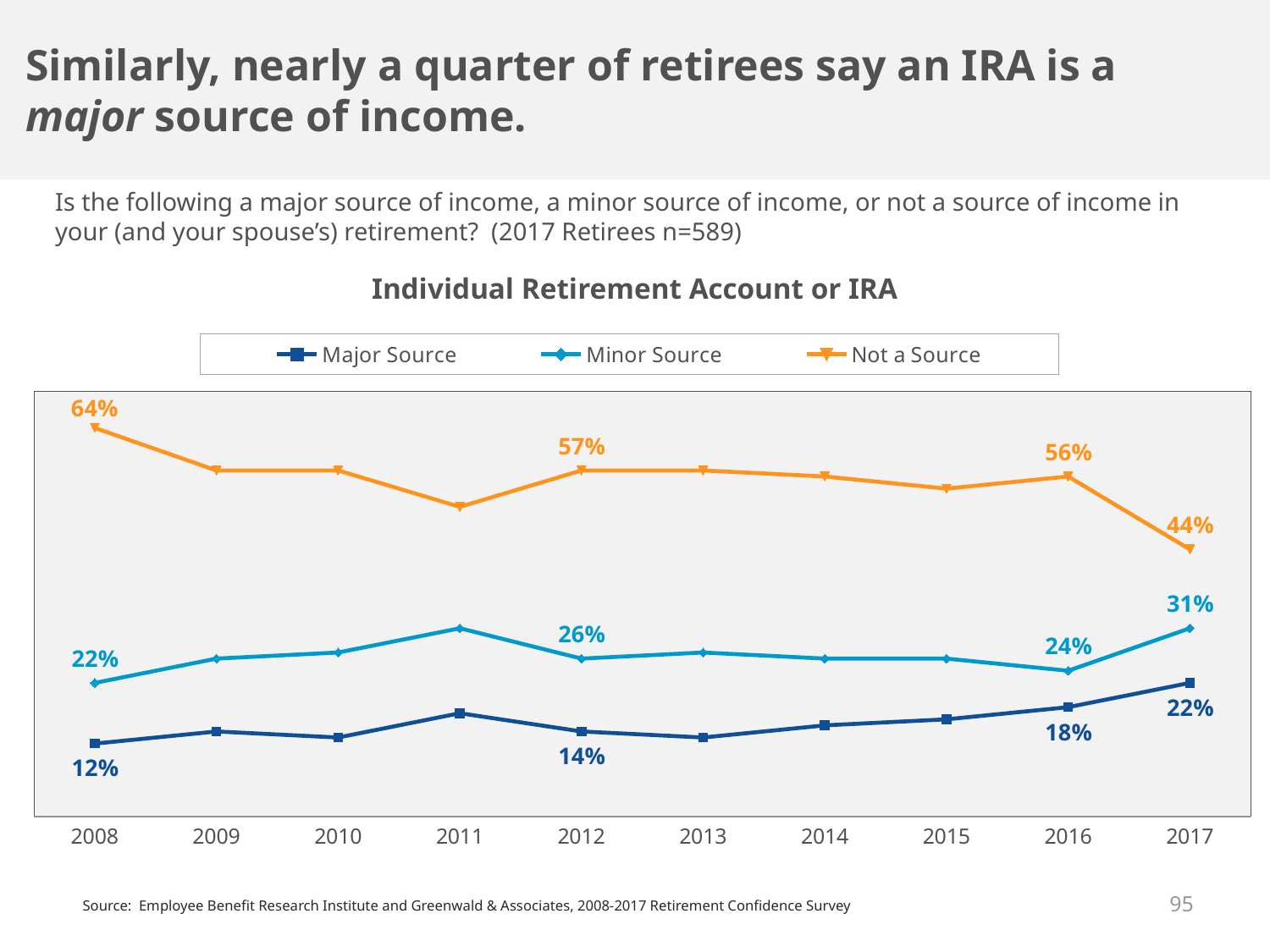
Does the Major Source series rise or fall from 2008 to 2017? rise What is the value for Minor Source in 2012? 26% What is the value for Major Source in 2017? 22% What kind of chart is shown on the slide? line chart Which series has the highest value in 2017? Not a Source Which is larger in 2016, Minor Source or Major Source? Minor Source How many series does the legend list? 3 What is the difference between the Not a Source values in 2016 and 2017? 12% What is the value for Not a Source in 2017? 44% What is the value for Not a Source in 2008? 64% How many years are shown on the x axis? 10 Which series has the lowest value in 2008? Major Source